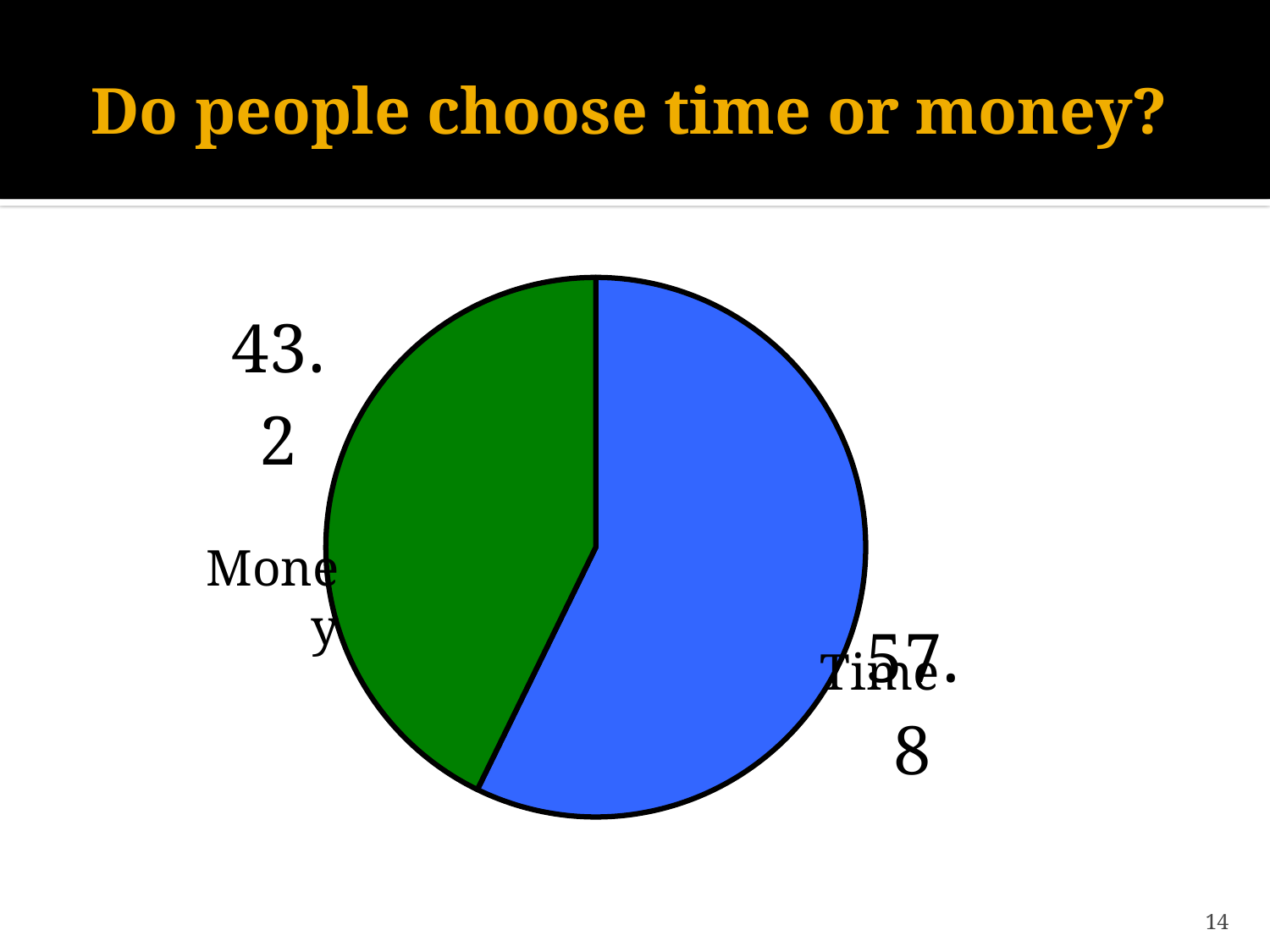
What is the title of the slide containing the chart? Do people choose time or money? What is the difference between the Time value and the Money value? 14.6 What is the value shown for the Money slice? 43.2 What kind of chart is shown on the slide? pie chart What colour is the Money slice? green What is the value shown for the Time slice? 57.8 Which is larger, the Time slice or the Money slice? Time How many slices does the pie chart have? 2 Which slice is the largest? Time Which slice is the smallest? Money